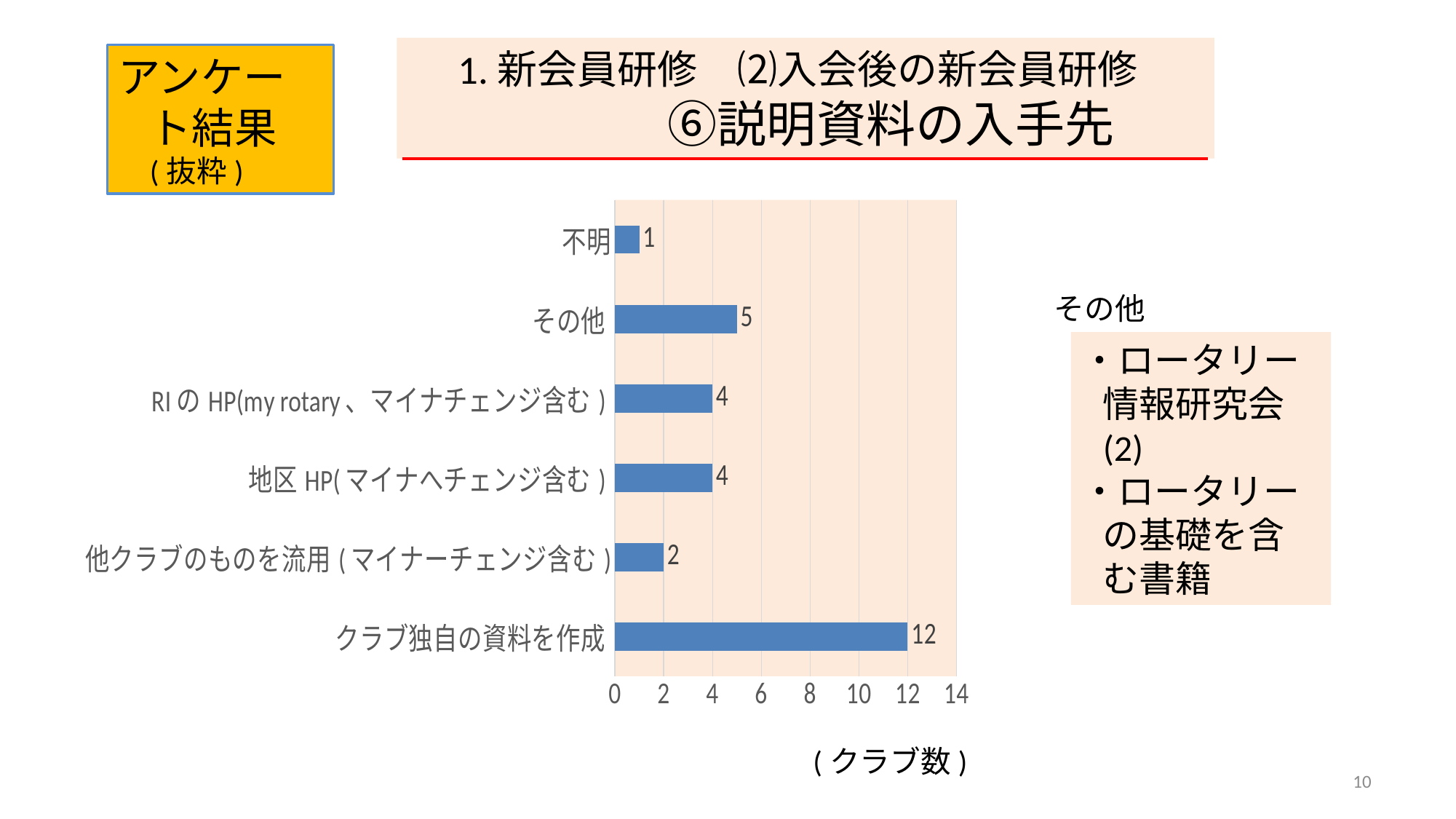
Is the value for クラブ独自の資料を作成 greater or less than 10? greater What is the value for 他クラブのものを流用(マイナーチェンジ含む)? 2 What is the difference between the values for クラブ独自の資料を作成 and その他? 7 What unit is indicated below the chart's axis? クラブ数 Which category has the lowest value? 不明 What is the value for その他? 5 Which is larger, the value for その他 or the value for 地区HP(マイナへチェンジ含む)? その他 What is the value for 不明? 1 How many categories are shown in the chart? 6 What is the value for クラブ独自の資料を作成? 12 What kind of chart is shown on the slide? bar chart Which category has the highest value? クラブ独自の資料を作成